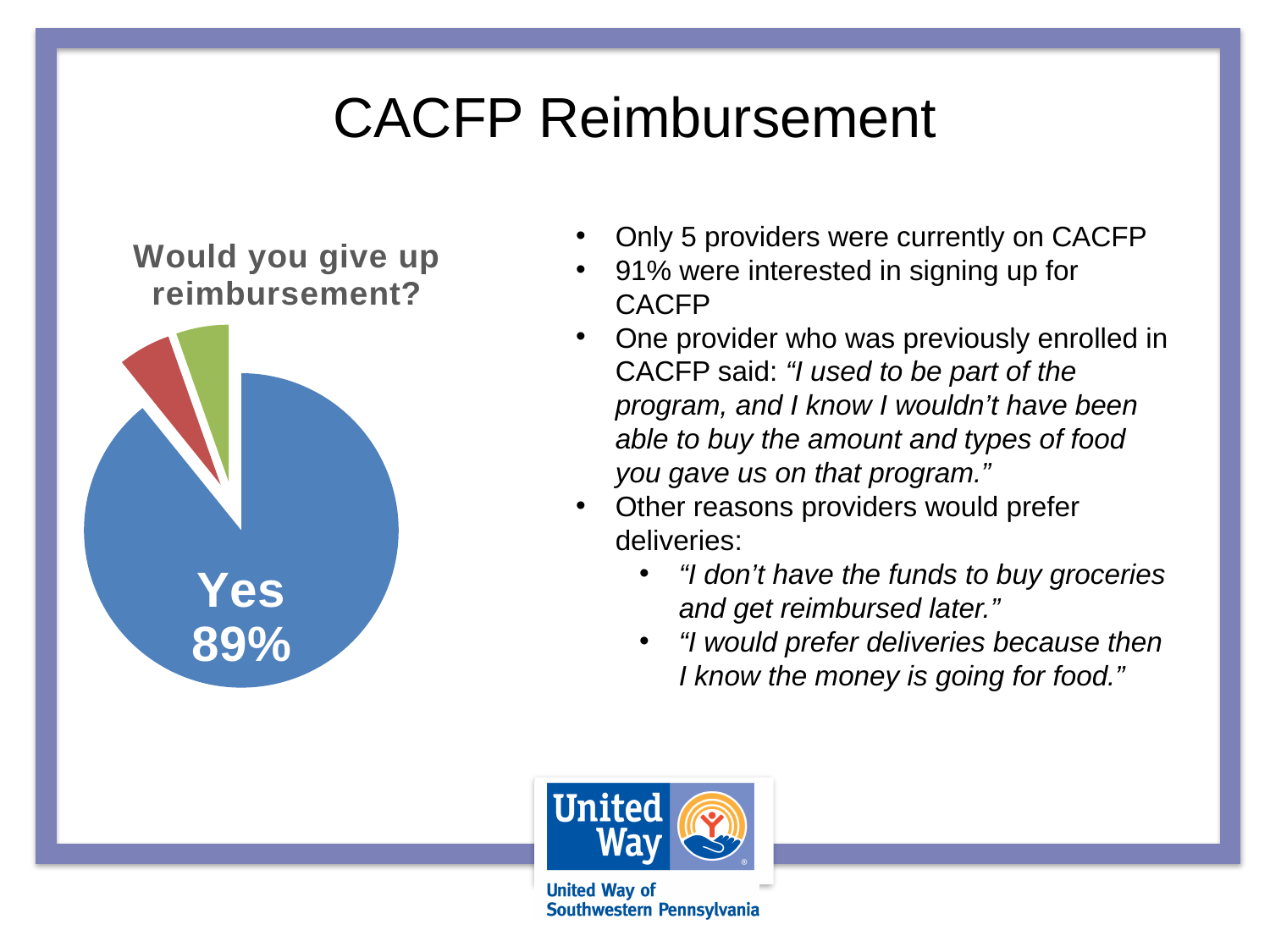
How many slices does the pie chart have? 3 What kind of chart is shown on the slide? pie chart What is the title of the pie chart? Would you give up reimbursement? What share of the pie does the "Yes" slice represent? 89% Which slice of the pie chart is the largest? Yes What percentage of the pie chart is labelled "Yes"? 89% What colour is the "Yes" slice in the pie chart? blue